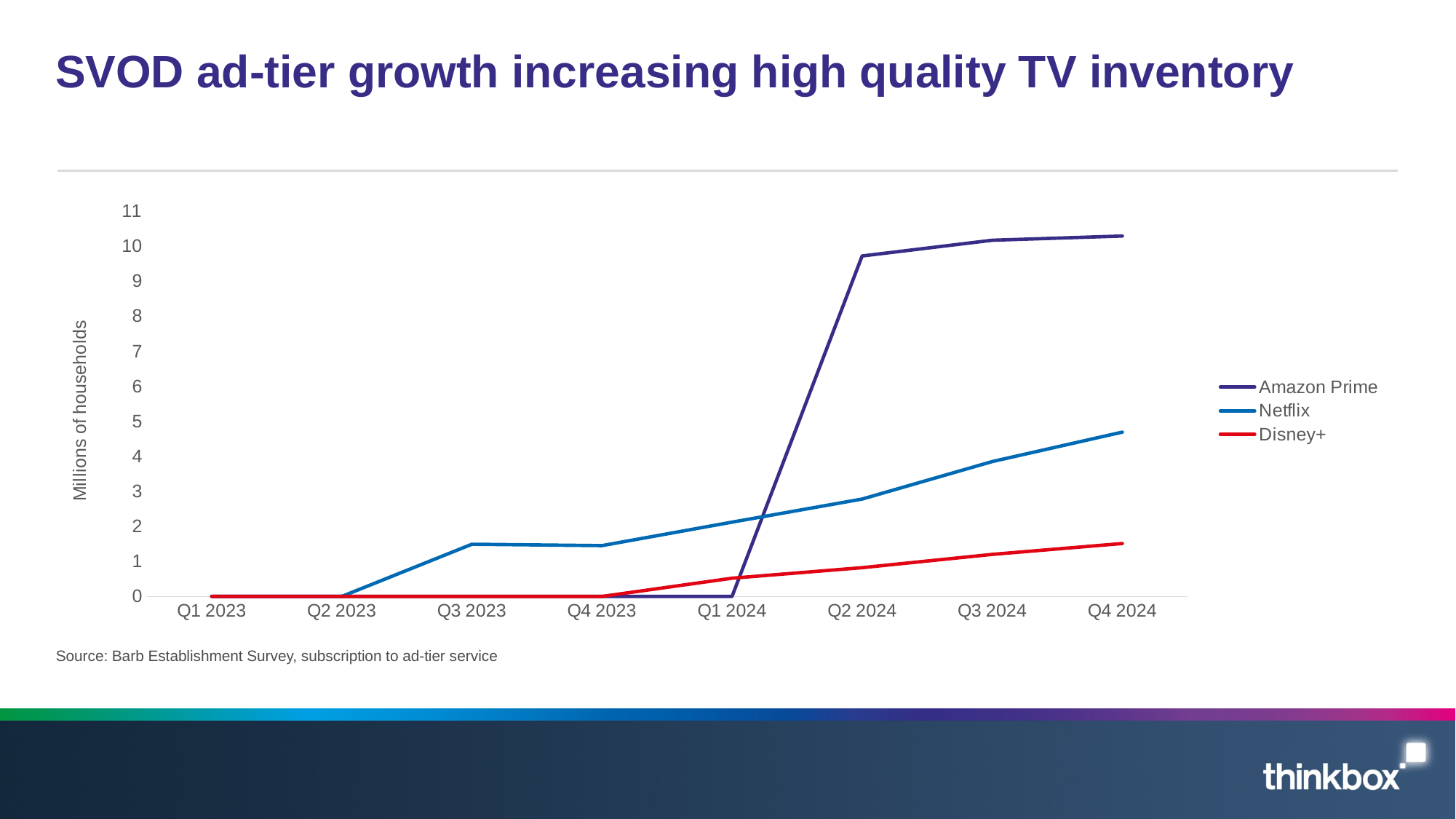
How many quarters are shown along the x axis? 8 Does the Netflix line rise or fall from Q4 2023 to Q4 2024? rise Is the value for Amazon Prime in Q4 2024 greater or less than 10? greater What is the label on the y axis? Millions of households What kind of chart is shown on the slide? line chart Which is larger in Q1 2024, Netflix or Amazon Prime? Netflix Is the value for Disney+ in Q4 2024 greater or less than 2? less Which series has the highest value in Q4 2024? Amazon Prime Is the value for Netflix in Q4 2024 greater or less than 5? less What is the value for Amazon Prime in Q1 2024? 0 Which series has the lowest value in Q4 2024? Disney+ How many series does the legend list? 3